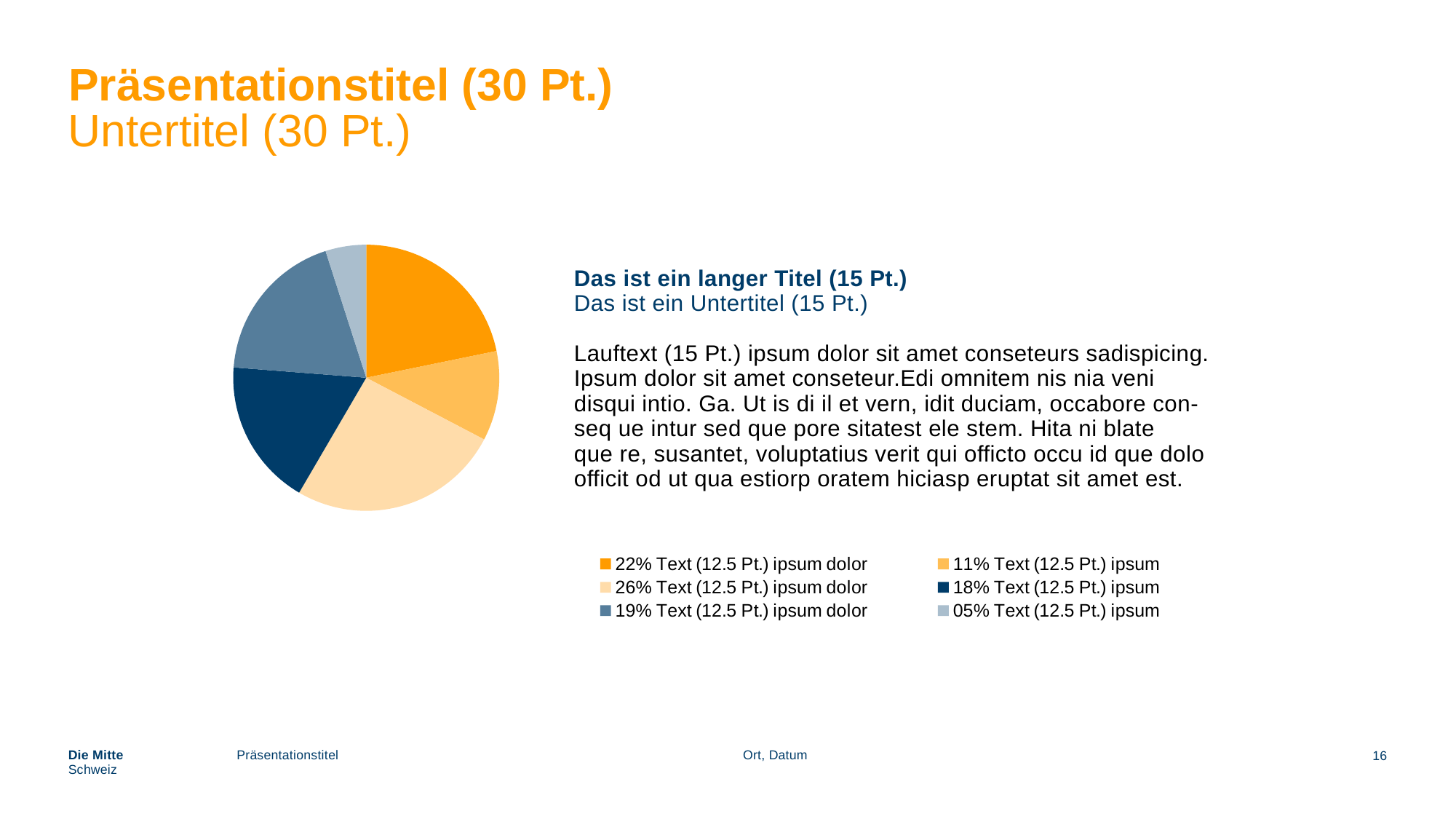
What share of the pie does the dark orange slice represent? 22% How many slices does the pie chart have? 6 What is the difference in percentage points between the largest slice (26%) and the dark orange slice (22%)? 4 percentage points What is the combined share of the two orange slices (22% and 11%)? 33% What kind of chart is shown on the slide? pie chart What share of the pie does the dark navy blue slice represent? 18% What share of the pie does the pale peach slice represent? 26% Which legend entry represents the largest slice of the pie chart? 26% Text (12.5 Pt.) ipsum dolor How many entries does the legend of the pie chart list? 6 Which legend entry represents the smallest slice of the pie chart? 05% Text (12.5 Pt.) ipsum Which is larger: the slate blue slice (19%) or the dark navy slice (18%)? the slate blue slice (19%)